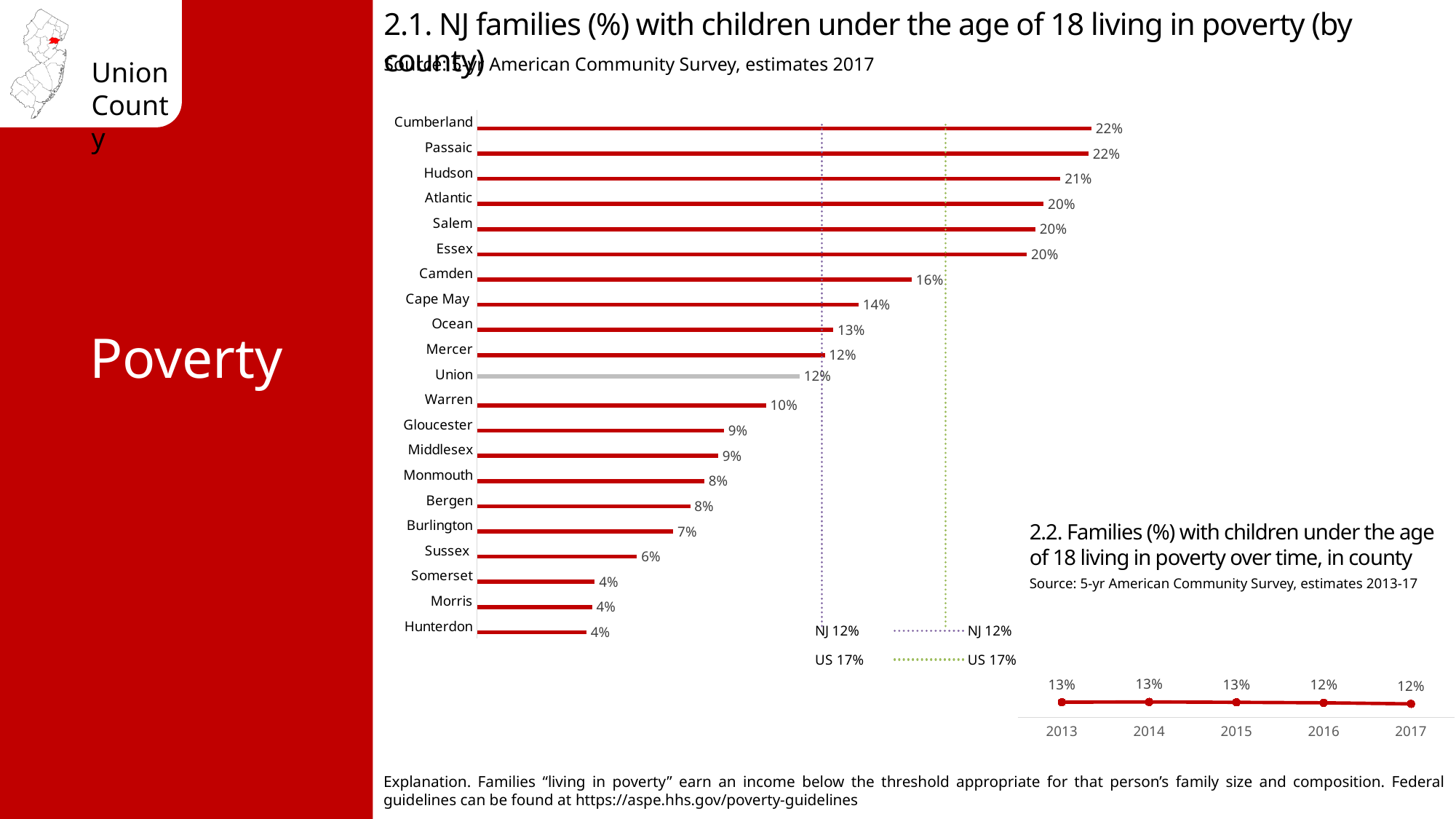
In chart 2.2, how many years are plotted? 5 In chart 2.1, which has a higher value, Camden or Cape May? Camden In chart 2.1, what percentage of families with children under 18 live in poverty in Camden? 16% In chart 2.1, what is the value shown for Hudson? 21% In chart 2.1, what is the difference between the values for Camden and Union? 4 percentage points What kind of chart is chart 2.1? Bar chart In chart 2.1, what is the value shown for Hunterdon? 4% In chart 2.2, do the values rise or fall from 2013 to 2017? Fall In chart 2.1, what is the US reference value shown by the dotted line? 17% In chart 2.1, what is the value shown for Union county? 12% In chart 2.2, what is the value for 2013? 13% In chart 2.1, how many counties are listed? 21